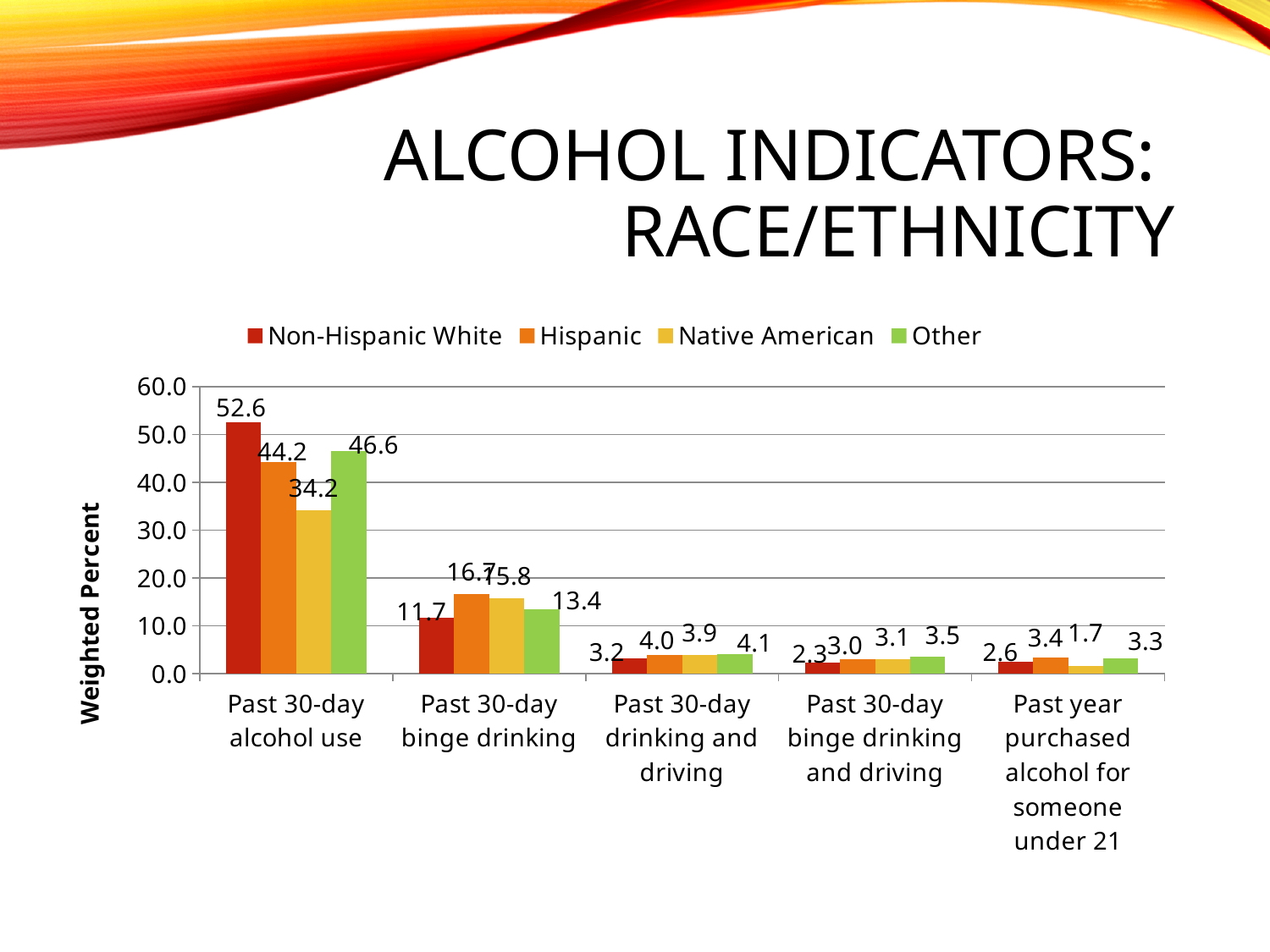
What is the value for Native American for Past 30-day binge drinking? 15.8 Which group has the highest value for Past 30-day binge drinking? Hispanic What is the value for Other for Past year purchased alcohol for someone under 21? 3.3 How many series does the legend list? 4 What is the label of the y axis? Weighted Percent Is the value for Other for Past 30-day alcohol use greater or less than 40.0? greater Which is larger for Past 30-day binge drinking and driving: the Non-Hispanic White value or the Other value? Other How many categories are shown on the x axis? 5 What is the value for Non-Hispanic White for Past 30-day alcohol use? 52.6 Which group has the lowest value for Past 30-day alcohol use? Native American What is the difference between the Non-Hispanic White and Hispanic values for Past 30-day alcohol use? 8.4 What kind of chart is shown on the slide? bar chart